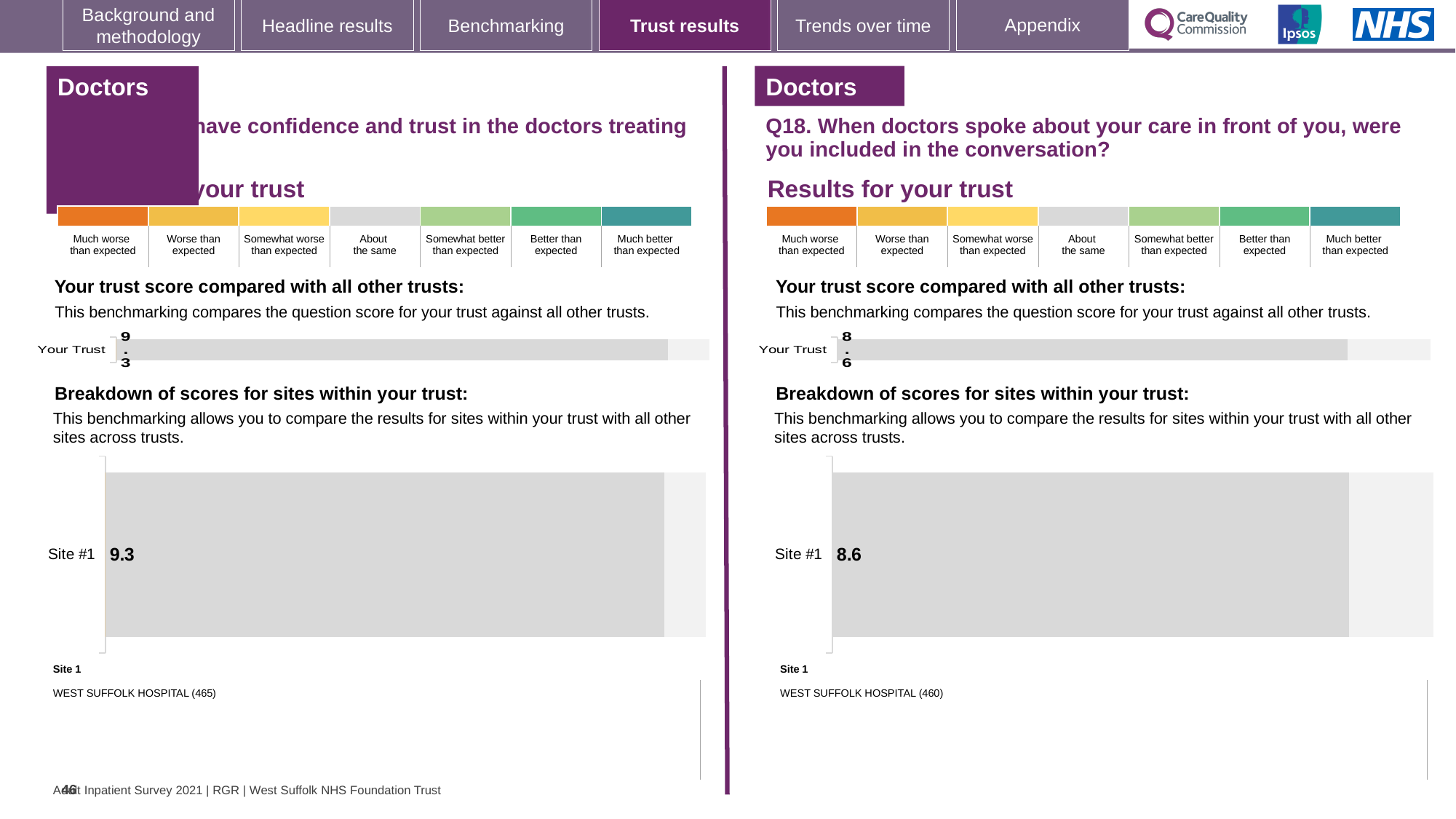
On the right half of the slide (Q18), what is the score shown for Site #1 in the breakdown of scores for sites within your trust? 8.6 How many sites are shown in the breakdown of scores chart for Q18 on the right half of the slide? 1 Which hospital is listed as Site 1 below the Q18 chart on the right half of the slide? WEST SUFFOLK HOSPITAL (460) Which Site #1 score is larger: the one on the left half of the slide or the one for Q18 on the right half? The left half (9.3) What is the difference between the Site #1 score on the left half of the slide and the Site #1 score for Q18 on the right half? 0.7 On the left half of the slide, what is the score shown for Site #1 in the breakdown of scores for sites within your trust? 9.3 Which hospital is listed as Site 1 below the chart on the left half of the slide? WEST SUFFOLK HOSPITAL (465) On the right half of the slide (Q18), what is the 'Your Trust' score in the trust score comparison chart? 8.6 How many sites are shown in the breakdown of scores chart on the left half of the slide? 1 On the left half of the slide, what is the 'Your Trust' score in the trust score comparison chart? 9.3 What type of chart is used to show the breakdown of scores for sites within your trust on the right half of the slide (Q18)? Bar chart